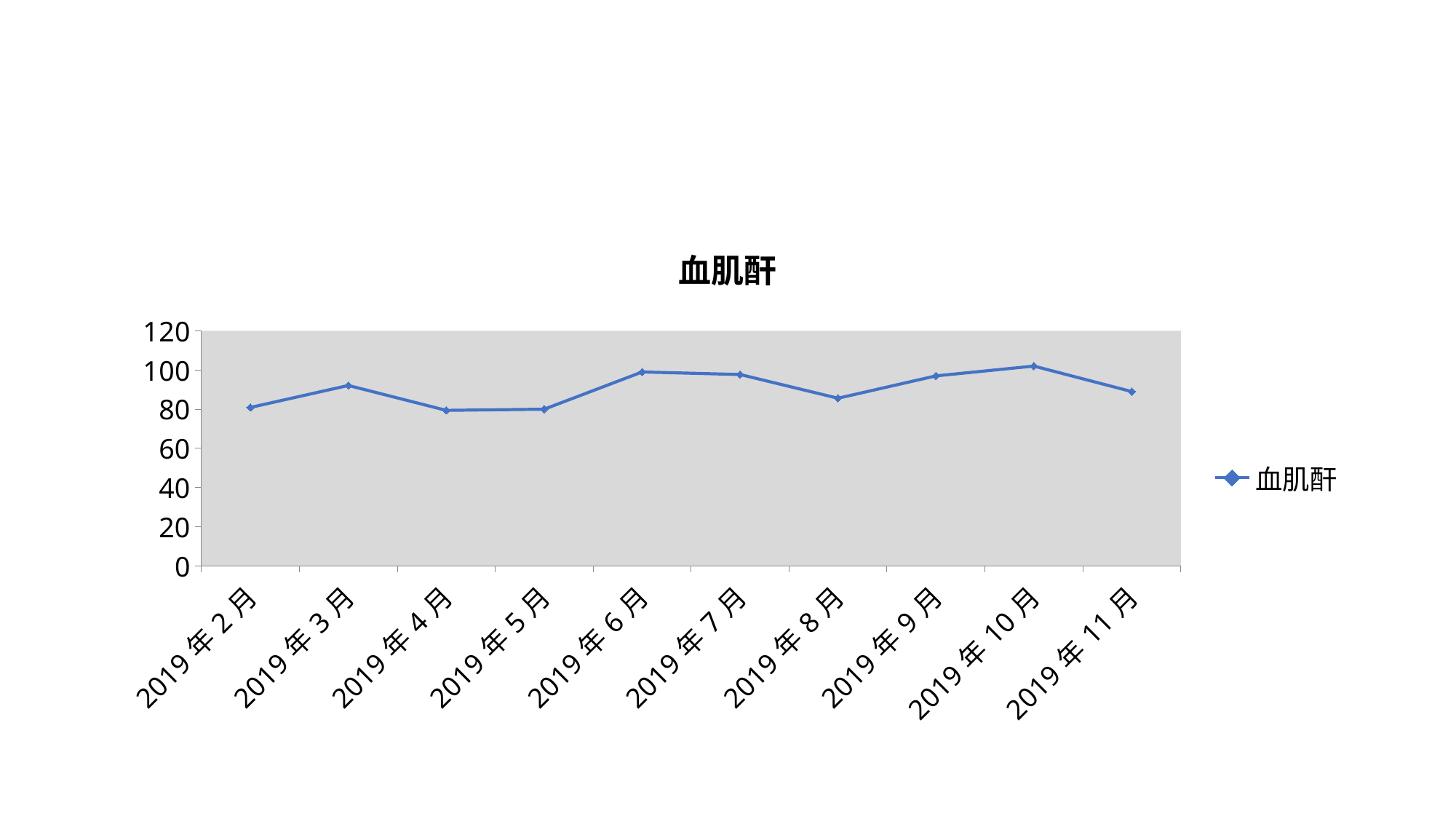
Is the value for 2019年9月 greater or less than 80? greater Which is larger, the value for 2019年6月 or 2019年8月? 2019年6月 Is the value for 2019年8月 greater or less than 100? less How many series does the legend list? 1 Which is larger, the value for 2019年3月 or 2019年4月? 2019年3月 What kind of chart is shown on the slide? line chart Is the value for 2019年3月 greater or less than 80? greater How many data points are plotted along the x axis? 10 What is the title of the chart? 血肌酐 Which is larger, the value for 2019年10月 or 2019年11月? 2019年10月 Does the value rise or fall from 2019年10月 to 2019年11月? fall